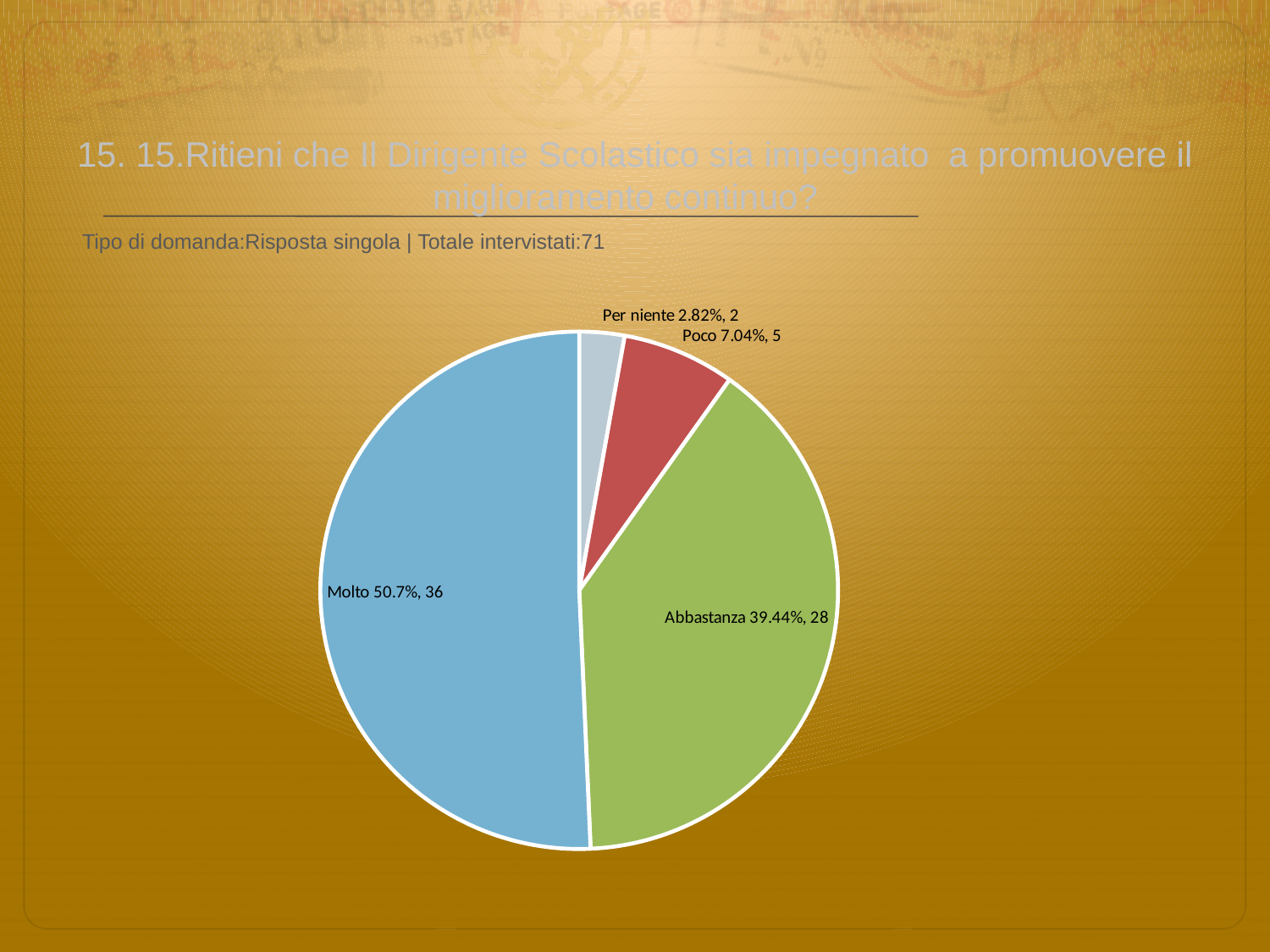
How many slices does the pie chart have? 4 Which response category has the smallest slice? Per niente What percentage share does the 'Poco' slice have? 7.04% What is the total number of respondents across all slices? 71 What colour is the 'Abbastanza' slice? green What kind of chart is shown on the slide? pie chart What is the difference in respondent count between 'Molto' and 'Abbastanza'? 8 Which response category has the largest slice? Molto How many respondents answered 'Abbastanza'? 28 How many respondents answered 'Per niente'? 2 Which has more respondents, 'Poco' or 'Per niente'? Poco What percentage share does the 'Molto' slice have? 50.7%